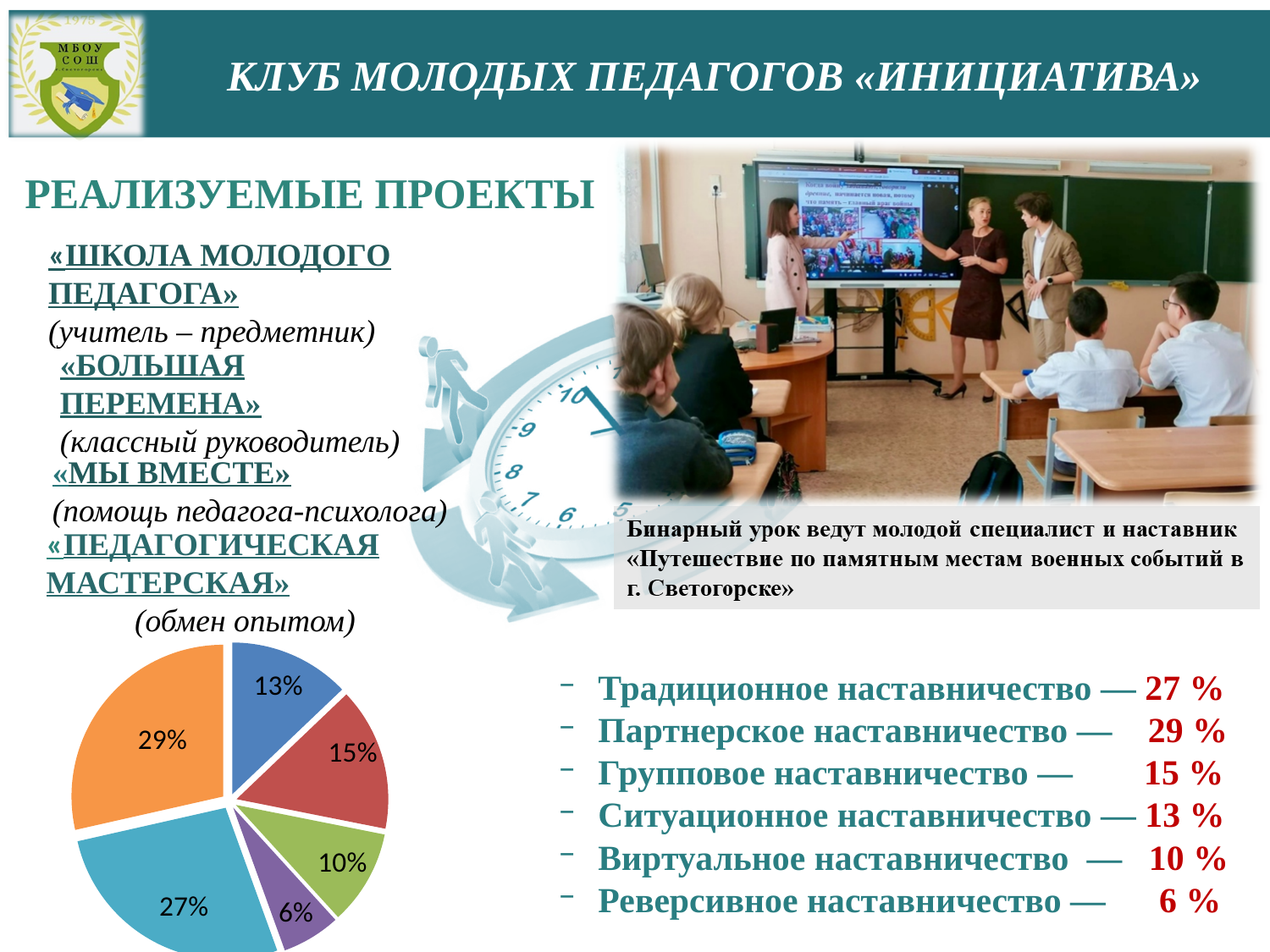
What value is shown on the green slice of the pie chart? 10% Which slice is larger in the pie chart, the red one or the green one? the red one How many slices does the pie chart have? 6 What colour is the largest slice of the pie chart? orange What is the value of the largest slice in the pie chart? 29% What kind of chart is shown at the bottom left of the slide? pie chart What is the difference between the largest and the smallest slice of the pie chart? 23% According to the slide, which type of mentoring has the largest share? Партнерское наставничество According to the slide, what share does Групповое наставничество have? 15 % What is the value of the smallest slice in the pie chart? 6% What value is shown on the light blue (teal) slice of the pie chart? 27% What value is shown on the blue slice of the pie chart? 13%